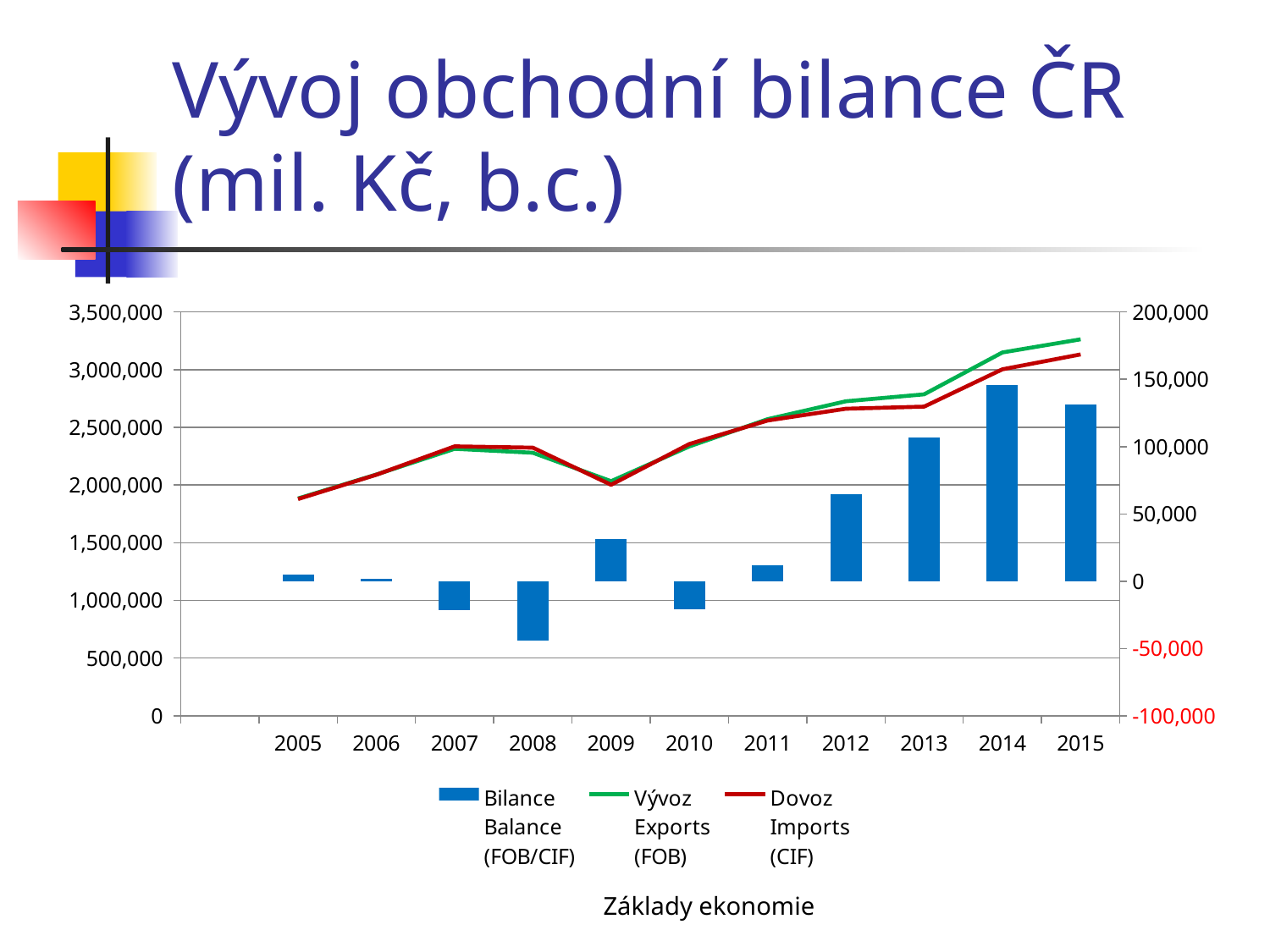
Is the Vývoz (Exports) value for 2015 greater or less than 3,000,000? greater What colour are the Bilance (Balance) bars? Blue What kind of chart is shown on the slide? A combination bar and line chart Is the Bilance (Balance) value for 2008 greater or less than 0? less Is the Bilance (Balance) value for 2014 greater or less than 100,000 on the right-hand axis? greater How many years are shown on the x axis? 11 Do the Vývoz (Exports) values generally rise or fall from 2005 to 2015? rise In which year is the Bilance (Balance) bar the highest? 2014 How many series does the legend list? 3 Which is larger in 2014, Vývoz (Exports) or Dovoz (Imports)? Vývoz (Exports) In which year is the Bilance (Balance) bar the lowest? 2008